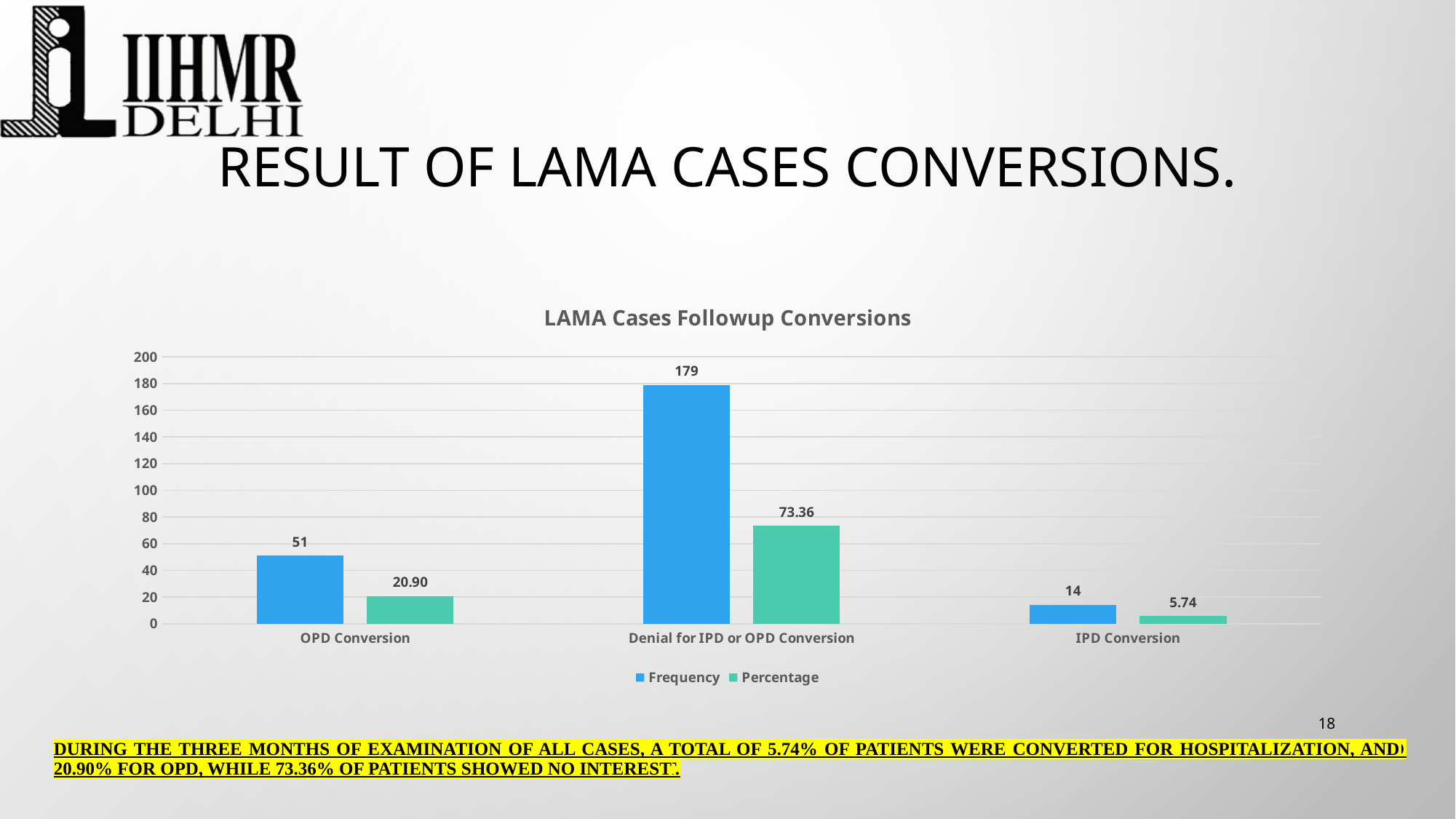
What type of chart is shown on the slide? Bar chart Which category has the highest Frequency? Denial for IPD or OPD Conversion What is the Percentage value for IPD Conversion? 5.74 What is the Frequency value for IPD Conversion? 14 Is the Frequency for Denial for IPD or OPD Conversion greater or less than 160? greater How many categories are shown on the x axis? 3 What is the Frequency value for Denial for IPD or OPD Conversion? 179 Which category has the lowest Percentage? IPD Conversion Which is larger: the Frequency for OPD Conversion or the Frequency for IPD Conversion? OPD Conversion What is the difference between the Frequency for Denial for IPD or OPD Conversion and the Frequency for OPD Conversion? 128 How many series does the legend list? 2 What is the Percentage value for OPD Conversion? 20.90